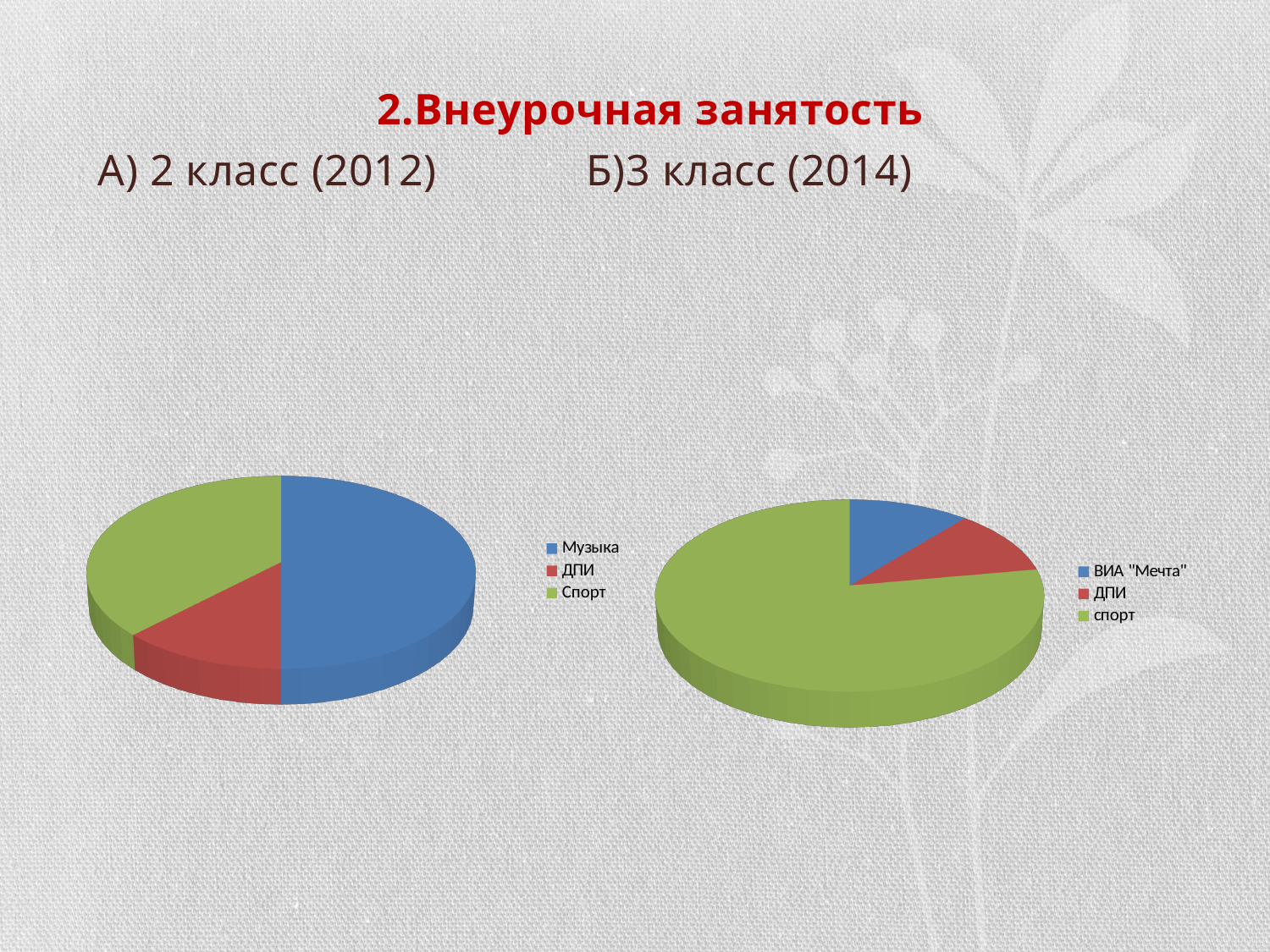
In the right chart (Б)3 класс (2014)), which category has the largest slice? спорт In the right chart (Б)3 класс (2014)), how many categories does the legend list? 3 In the left chart (А) 2 класс (2012)), how many categories does the legend list? 3 What kind of chart is the right chart (Б)3 класс (2014))? pie chart In the left chart (А) 2 класс (2012)), which slice is larger, Музыка or Спорт? Музыка In the right chart (Б)3 класс (2014)), which slice is larger, ДПИ or спорт? спорт In the right chart (Б)3 класс (2014)), which colour represents ВИА "Мечта"? blue In the left chart (А) 2 класс (2012)), which category has the largest slice? Музыка What kind of chart is the left chart (А) 2 класс (2012))? pie chart In the left chart (А) 2 класс (2012)), which category has the smallest slice? ДПИ In the left chart (А) 2 класс (2012)), which category is shown in red? ДПИ